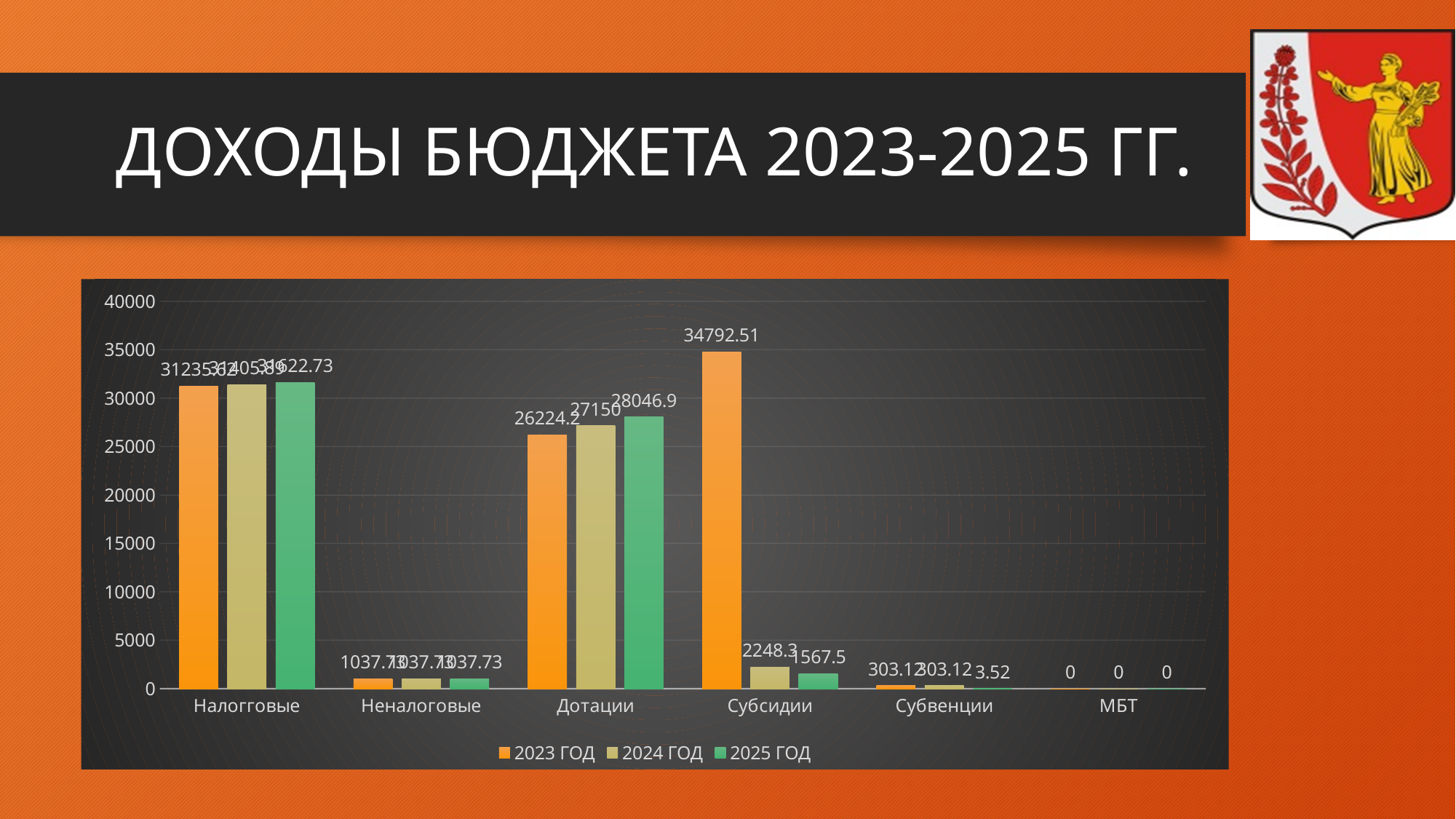
How many series does the legend list? 3 Is the 2023 ГОД value for Налогговые greater or less than 30000? greater How many categories are shown on the x axis? 6 What is the title of the slide? ДОХОДЫ БЮДЖЕТА 2023-2025 ГГ. What is the value for Субвенции in 2025 ГОД? 3.52 What is the value for Субсидии in 2023 ГОД? 34792.51 Do the values for Дотации rise or fall from 2023 ГОД to 2025 ГОД? rise What is the value for МБТ in 2023 ГОД? 0 What is the value for Дотации in 2024 ГОД? 27150 What kind of chart is shown on the slide? bar chart What is the difference between the 2025 ГОД and 2023 ГОД values for Дотации? 1822.7 Which category has the highest value in the 2023 ГОД series? Субсидии